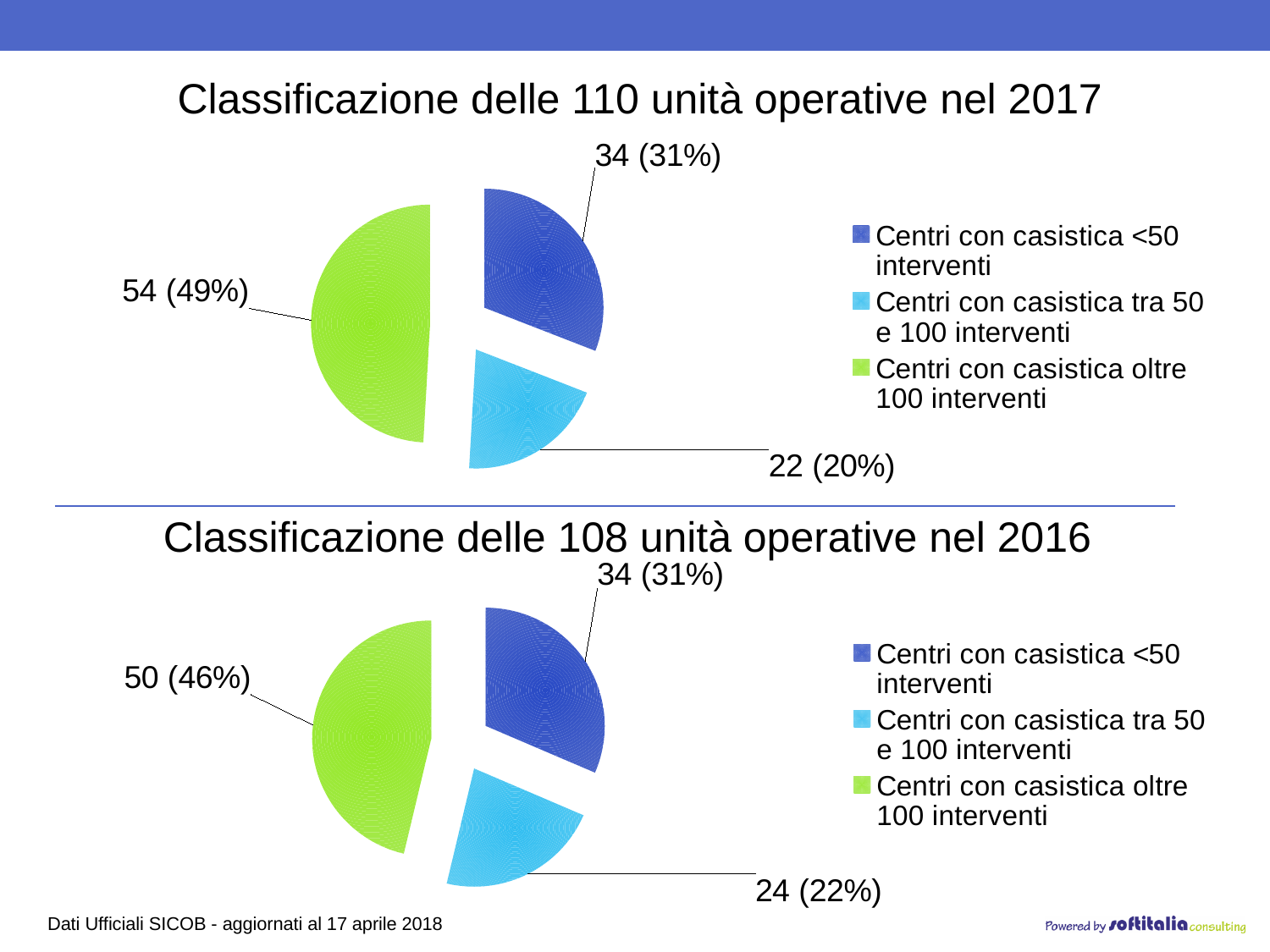
What is the title of the bottom chart? Classificazione delle 108 unità operative nel 2016 How many categories does the 2017 chart (top) show? 3 In the 2016 chart (bottom), what share of the pie is 'Centri con casistica oltre 100 interventi'? 46% In the 2017 chart (top), which category has the largest slice? Centri con casistica oltre 100 interventi In the 2016 chart (bottom), which category has the smallest slice? Centri con casistica tra 50 e 100 interventi In the 2017 chart (top), what is the value for 'Centri con casistica tra 50 e 100 interventi'? 22 (20%) In the 2016 chart (bottom), what is the value for 'Centri con casistica tra 50 e 100 interventi'? 24 (22%) What type of chart is used on this slide? Pie chart In the 2016 chart (bottom), what is the value for 'Centri con casistica <50 interventi'? 34 (31%) Comparing the two charts, is the number of 'Centri con casistica tra 50 e 100 interventi' larger in 2017 or in 2016? 2016 In the 2017 chart (top), what is the value for 'Centri con casistica oltre 100 interventi'? 54 (49%) In the 2017 chart (top), what is the difference between the number of centres with more than 100 interventions and those with fewer than 50? 20